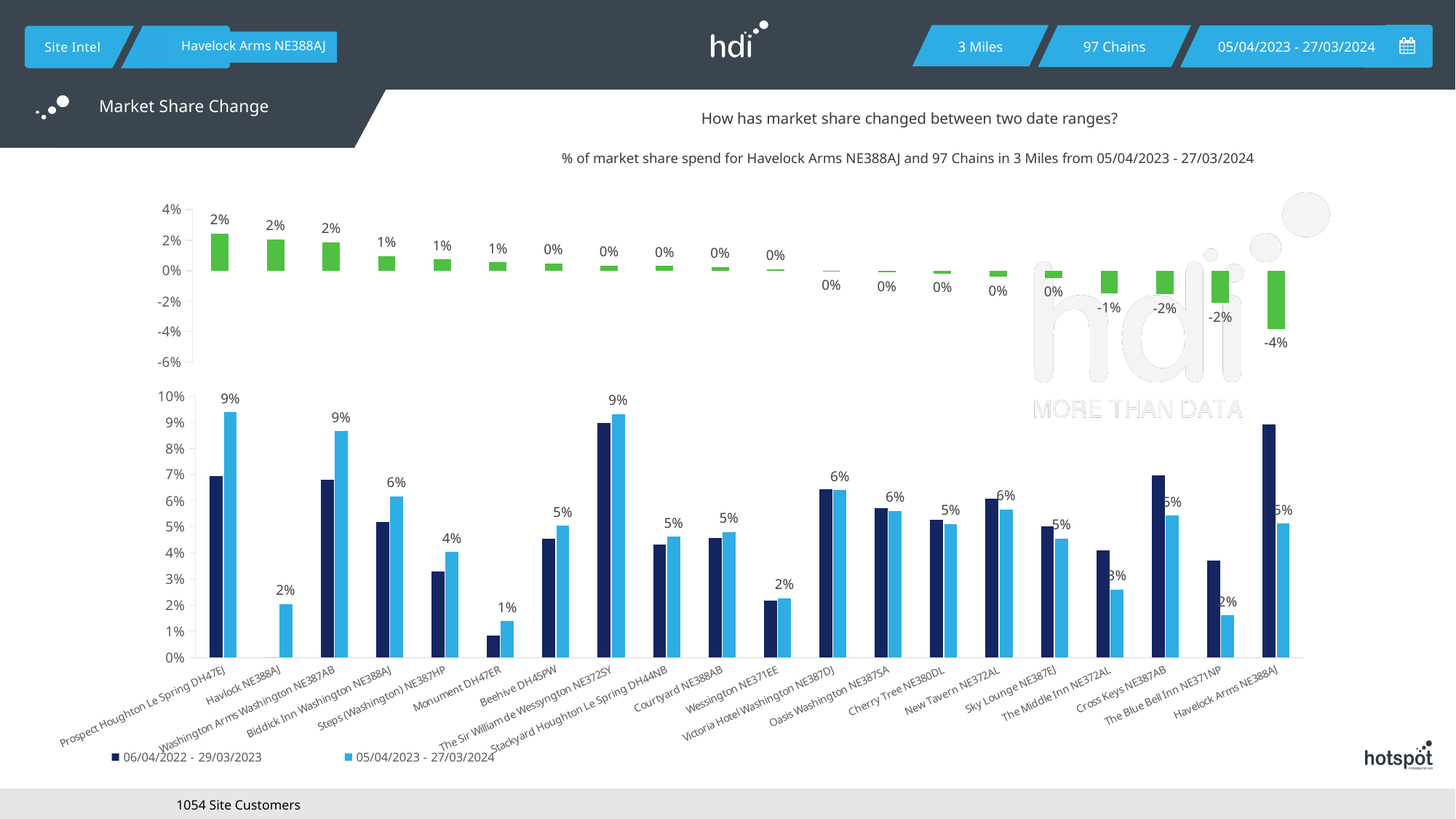
In the bottom chart, how many series does the legend list? 2 In the bottom chart, for the 05/04/2023 - 27/03/2024 series, which is larger: Prospect Houghton Le Spring DH47EJ or Havlock NE388AJ? Prospect Houghton Le Spring DH47EJ In the top chart (market share change), which category has the lowest value? Havelock Arms NE388AJ In the bottom chart, what is the 05/04/2023 - 27/03/2024 value for Monument DH47ER? 1% In the bottom chart, what is the 05/04/2023 - 27/03/2024 value for Biddick Inn Washington NE388AJ? 6% In the top chart (market share change), do the values rise or fall from left to right along the x axis? fall In the top chart (market share change), what is the value for Cross Keys NE387AB? -2% In the bottom chart, is the 06/04/2022 - 29/03/2023 value for Havelock Arms NE388AJ greater or less than 8%? greater In the bottom chart, how many categories are shown on the x axis? 20 What kind of chart is the bottom chart? bar chart In the top chart (market share change), what is the value for Prospect Houghton Le Spring DH47EJ? 2% In the top chart (market share change), what is the value for Havelock Arms NE388AJ? -4%